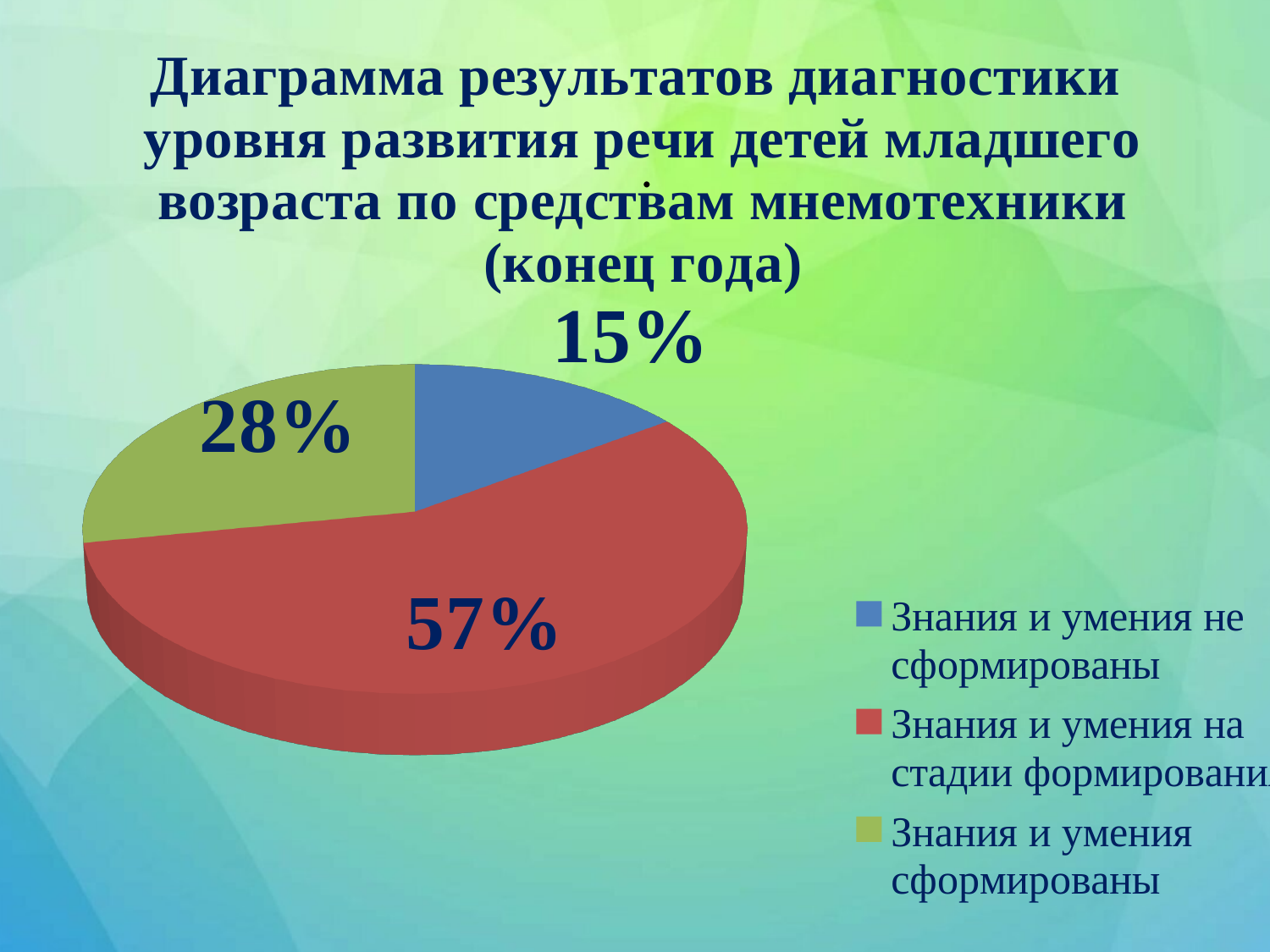
What share of the pie is labelled "Знания и умения не сформированы"? 15% What kind of chart is shown on the slide? pie chart What is the difference between the shares for "Знания и умения на стадии формирования" and "Знания и умения сформированы"? 29% What share of the pie is labelled "Знания и умения сформированы"? 28% How many slices does the pie chart have? 3 How many entries does the legend list? 3 What share of the pie is labelled "Знания и умения на стадии формирования"? 57% What is the difference between the shares for "Знания и умения сформированы" and "Знания и умения не сформированы"? 13% Which category has the smallest slice of the pie? Знания и умения не сформированы Which category has the largest slice of the pie? Знания и умения на стадии формирования Which is larger: the share for "Знания и умения сформированы" or the share for "Знания и умения не сформированы"? Знания и умения сформированы What colour is the slice for "Знания и умения на стадии формирования"? red